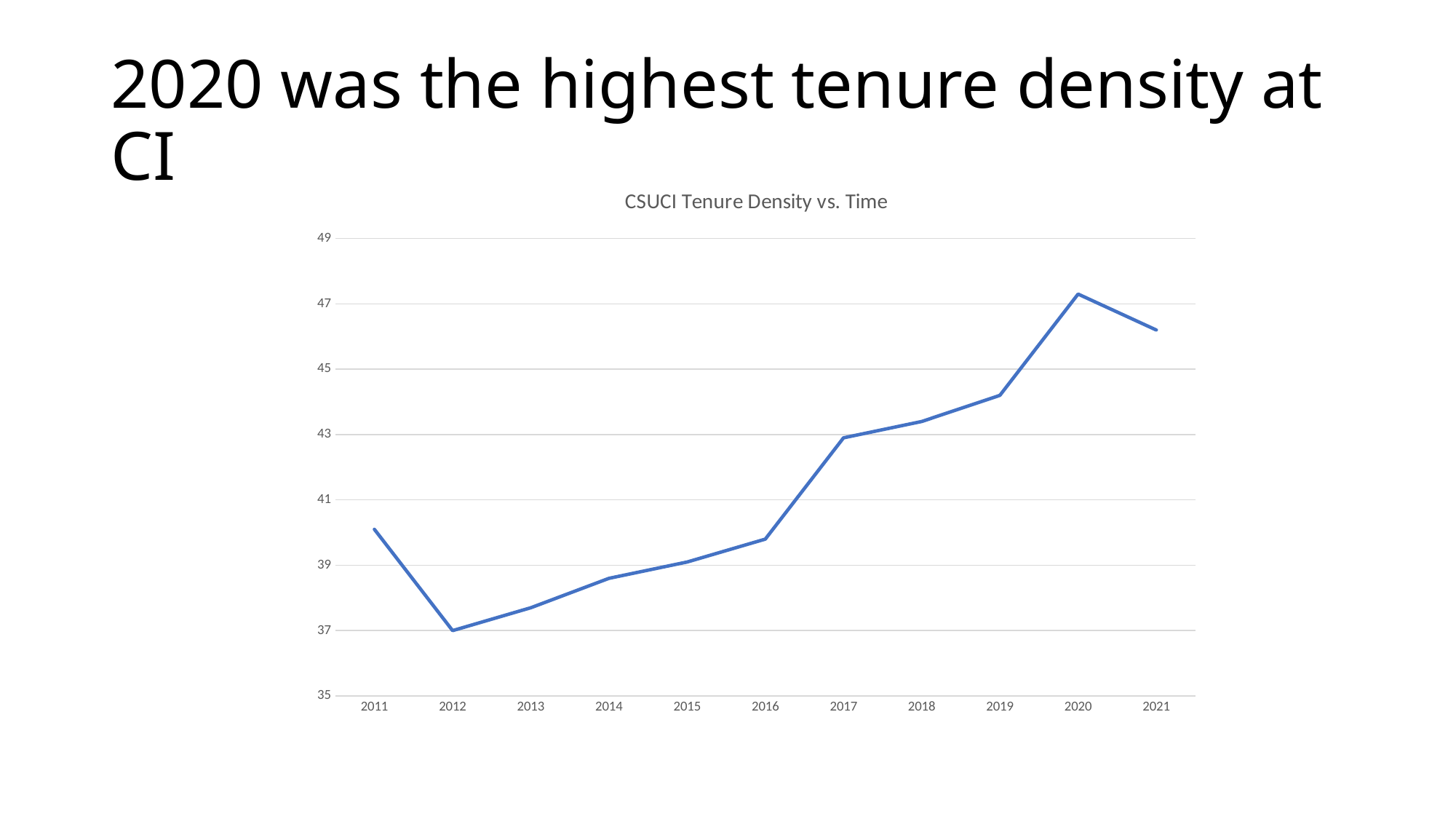
Which year has a higher tenure density, 2017 or 2014? 2017 What kind of chart is shown on the slide? line chart Is the value for 2020 greater or less than 47? greater Is the value for 2016 greater or less than 41? less Which year has a higher tenure density, 2021 or 2020? 2020 Which year has the highest tenure density in the chart? 2020 Is the value for 2011 greater or less than 39? greater Does the tenure density rise or fall between 2012 and 2020? rise Which year has the lowest tenure density in the chart? 2012 How many years are plotted on the x axis of the chart? 11 What is the title of the chart? CSUCI Tenure Density vs. Time